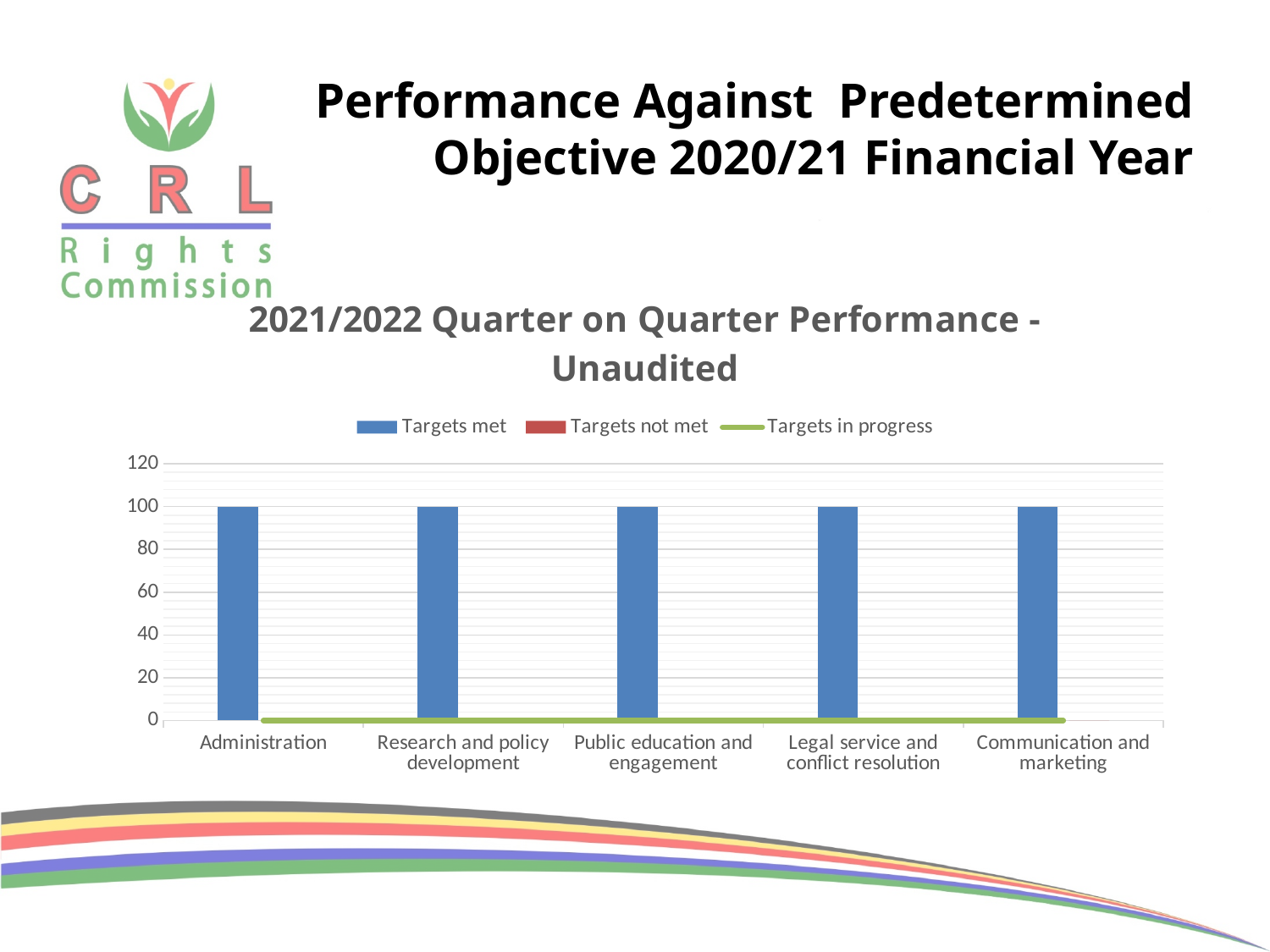
What kind of chart is shown on the slide? Bar chart Do the Targets met values rise, fall, or stay flat across the categories along the x axis? Stay flat What is the Targets met value for Legal service and conflict resolution? 100 How many categories are shown on the x axis? 5 What is the Targets met value for Communication and marketing? 100 What is the Targets in progress value for Public education and engagement? 0 What is the Targets met value for Administration? 100 What is the difference between the Targets met values for Administration and Public education and engagement? 0 How many series does the legend list? 3 What is the title of the chart? 2021/2022 Quarter on Quarter Performance - Unaudited Which series is shown in blue in the legend? Targets met Is the Targets met value for Research and policy development greater or less than 80? greater